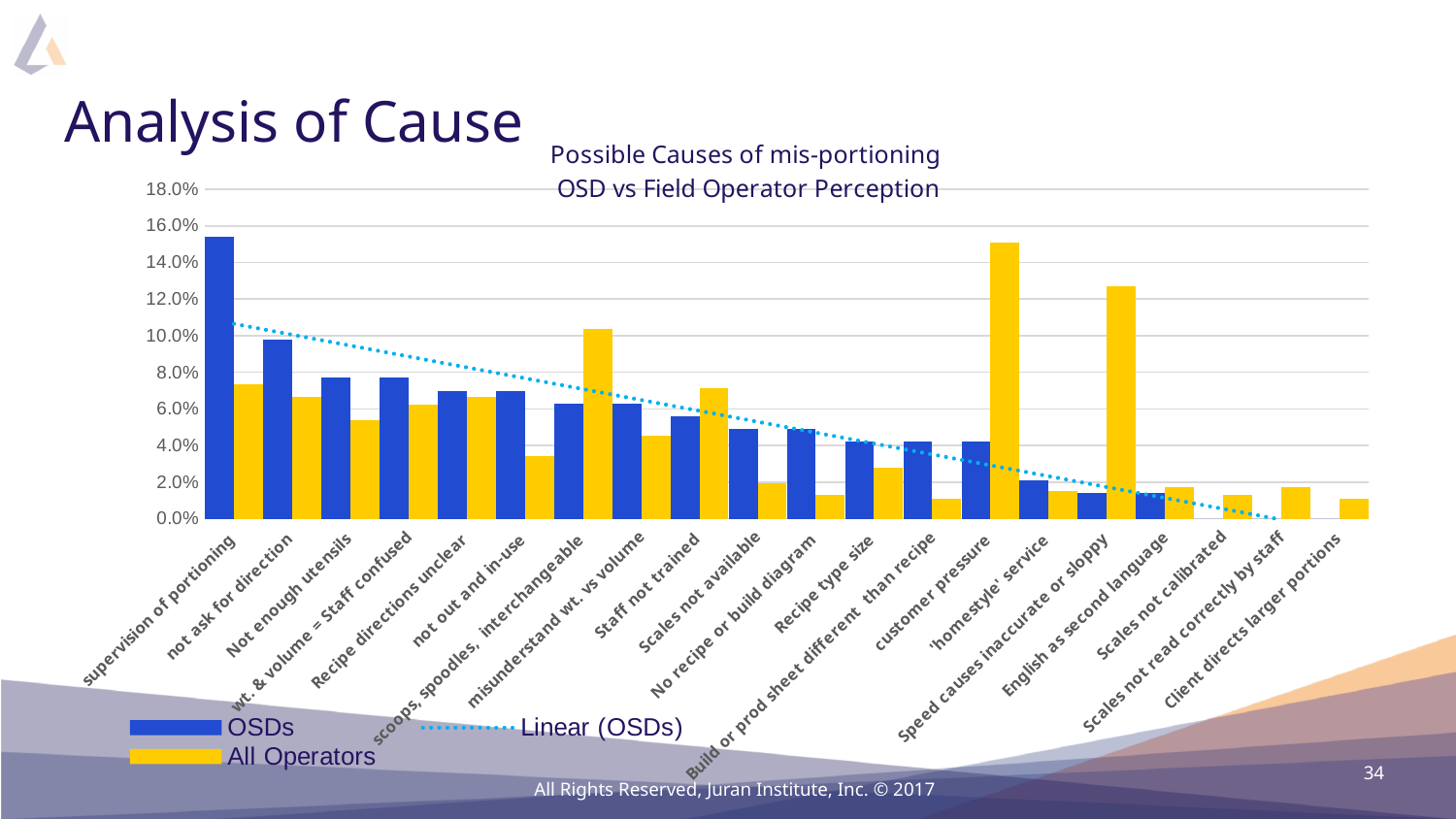
Is the OSDs value for supervision of portioning greater or less than 14.0%? greater For Scales not available, which series has the larger value, OSDs or All Operators? OSDs How many entries does the legend list? 3 Which category has the highest All Operators value? customer pressure Is the All Operators value for English as second language greater or less than 10.0%? less Which category has the highest OSDs value? supervision of portioning For customer pressure, which series has the larger value, OSDs or All Operators? All Operators How many categories are shown on the x axis? 20 Do the OSDs values generally rise or fall from left to right along the x axis? fall Is the OSDs value for Scales not calibrated greater or less than 4.0%? less What type of chart is shown on the slide? Bar chart